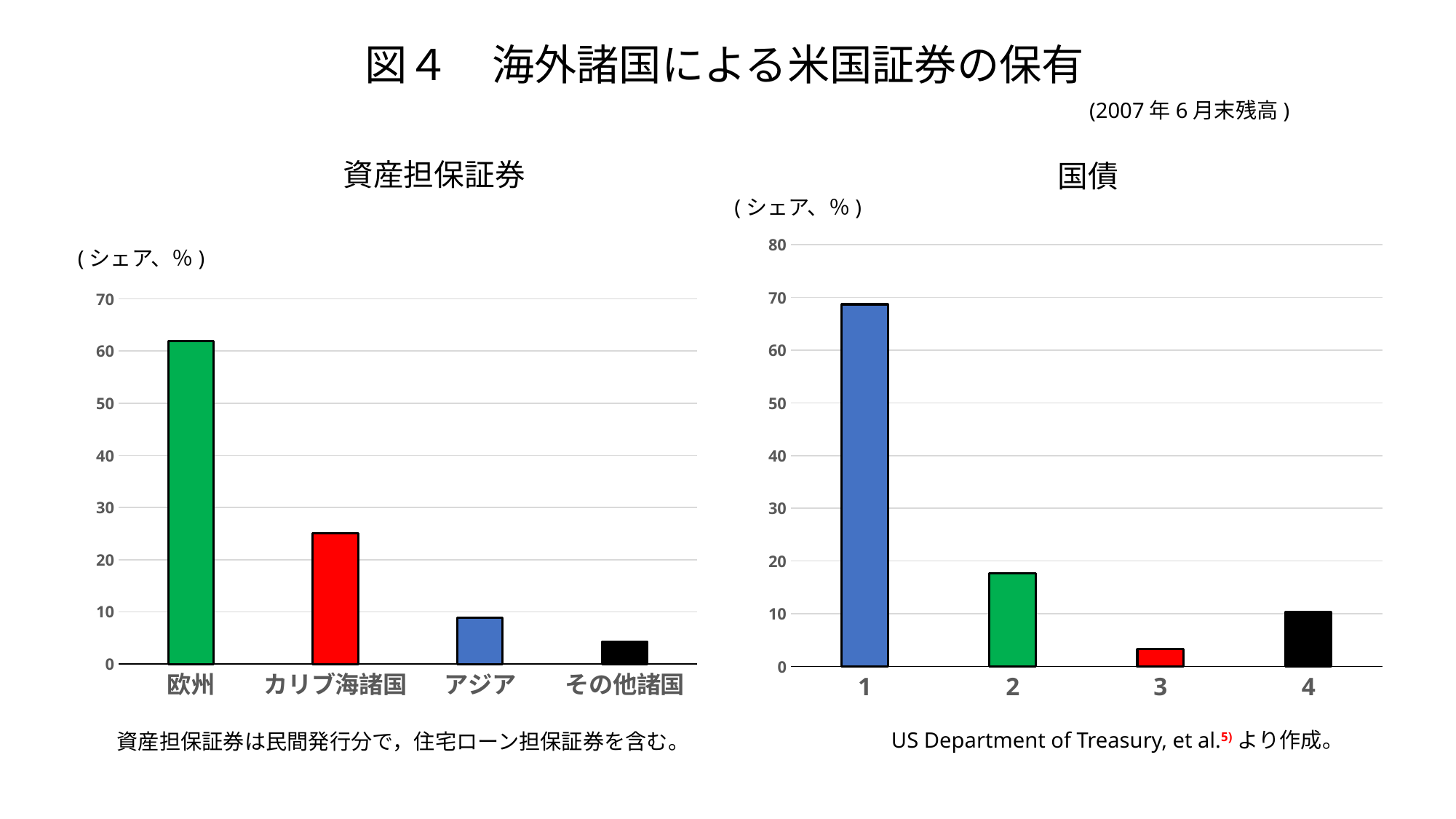
In the 資産担保証券 chart on the left, which category has the lowest value? その他諸国 In the 国債 chart on the right, which is larger, the value for category 2 or the value for category 4? 2 In the 資産担保証券 chart on the left, which is larger, the value for アジア or the value for その他諸国? アジア In the 資産担保証券 chart on the left, is the value for カリブ海諸国 greater or less than 30? less In the 国債 chart on the right, is the value for category 1 greater or less than 60? greater In the 資産担保証券 chart on the left, which category has the highest value? 欧州 In the 資産担保証券 chart on the left, is the value for 欧州 greater or less than 50? greater What unit label is shown above the y axis of the 国債 chart on the right? (シェア、%) What kind of chart is the 資産担保証券 chart on the left? bar chart In the 国債 chart on the right, which category has the highest value? 1 How many categories are shown in the 資産担保証券 chart on the left? 4 In the 国債 chart on the right, which category has the lowest value? 3